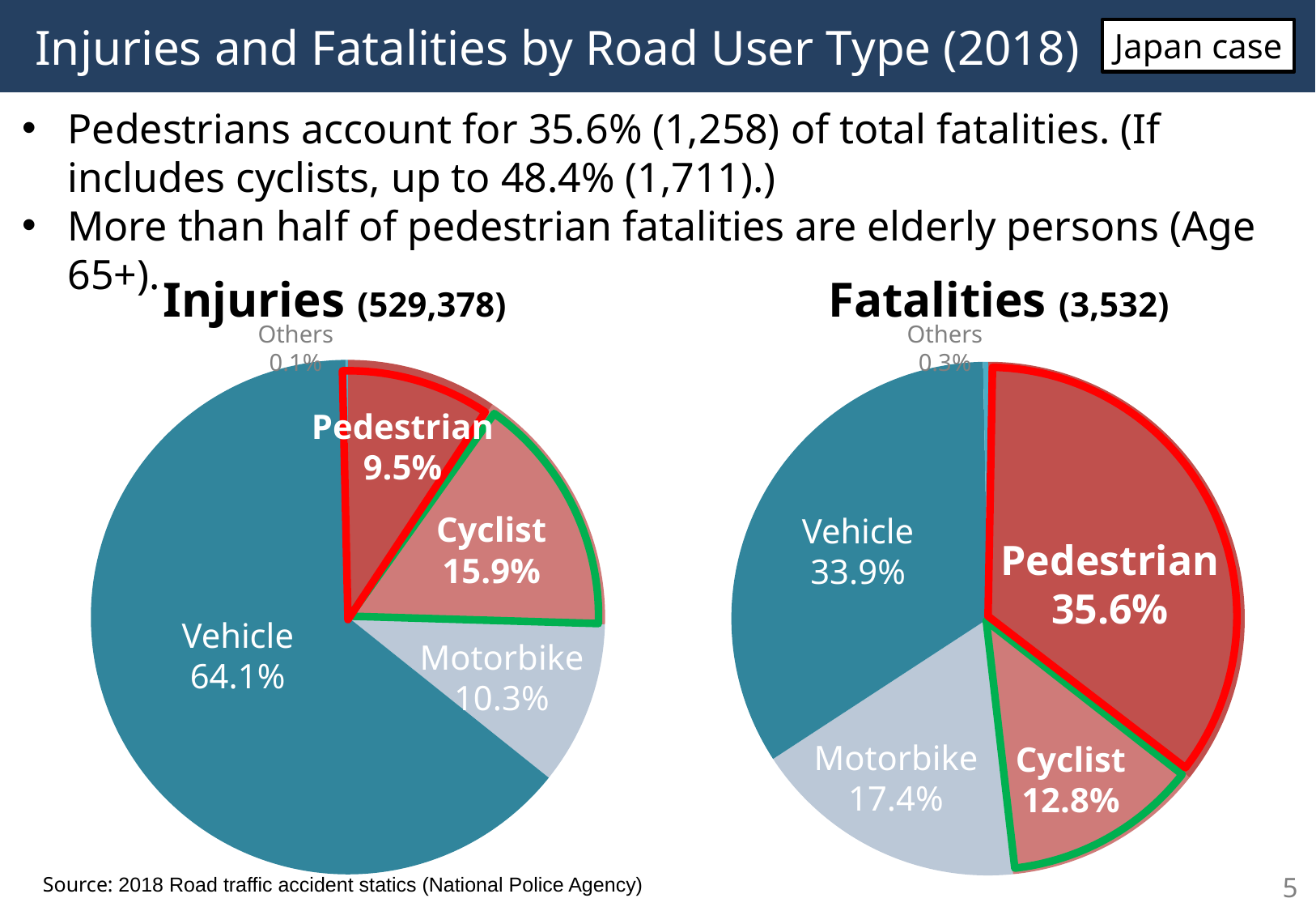
In the Fatalities pie chart, which category has the largest share? Pedestrian In the Fatalities pie chart, what is the share for Motorbike? 17.4% In the Injuries pie chart, what share of injuries is attributed to Vehicle? 64.1% In the Fatalities pie chart, what is the difference between the Pedestrian share and the Vehicle share? 1.7% In the Injuries pie chart, which category has the smallest share? Others In the Fatalities pie chart, what share of fatalities is attributed to Pedestrian? 35.6% In the Injuries pie chart, what is the share for Cyclist? 15.9% In the Injuries pie chart, which is larger, the Cyclist share or the Motorbike share? Cyclist What total number of fatalities is shown in the title of the Fatalities chart? 3,532 In the Injuries pie chart, what is the combined share of Pedestrian and Cyclist? 25.4% How many categories are shown in the Fatalities pie chart? 5 What type of chart is used to show Injuries? Pie chart